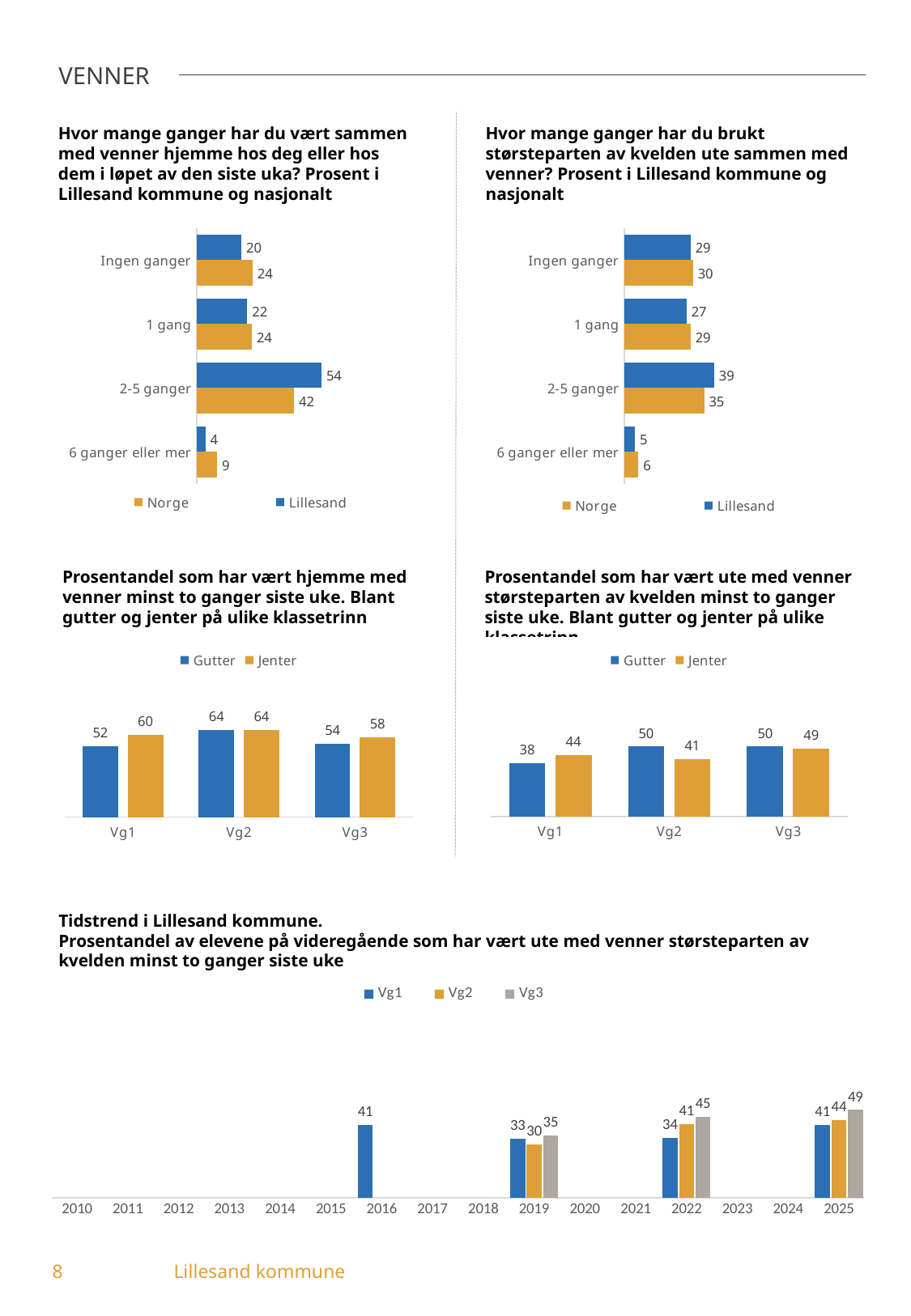
In the top-left chart (friends at home in the last week), what is the Lillesand value for '2-5 ganger'? 54 In the middle-left chart (at home with friends at least twice, by gender and grade), which is larger for Vg3: Gutter or Jenter? Jenter In the top-right chart (evening out with friends), which category has the highest Lillesand value? 2-5 ganger In the middle-left chart (at home with friends at least twice, by gender and grade), what is the Jenter value for Vg1? 60 In the top-right chart (evening out with friends), how many categories are shown? 4 In the bottom chart (Tidstrend i Lillesand kommune), how many series does the legend list? 3 In the middle-right chart (out with friends at least twice, by gender and grade), which grade has the lowest Gutter value? Vg1 In the top-right chart (evening out with friends), what is the Norge value for 'Ingen ganger'? 30 In the top-left chart (friends at home in the last week), what is the difference between the Lillesand and Norge values for '2-5 ganger'? 12 In the middle-right chart (out with friends at least twice, by gender and grade), what is the Gutter value for Vg2? 50 In the top-left chart (friends at home in the last week), what is the Norge value for '6 ganger eller mer'? 9 In the bottom chart (Tidstrend i Lillesand kommune), what is the Vg3 value for 2025? 49